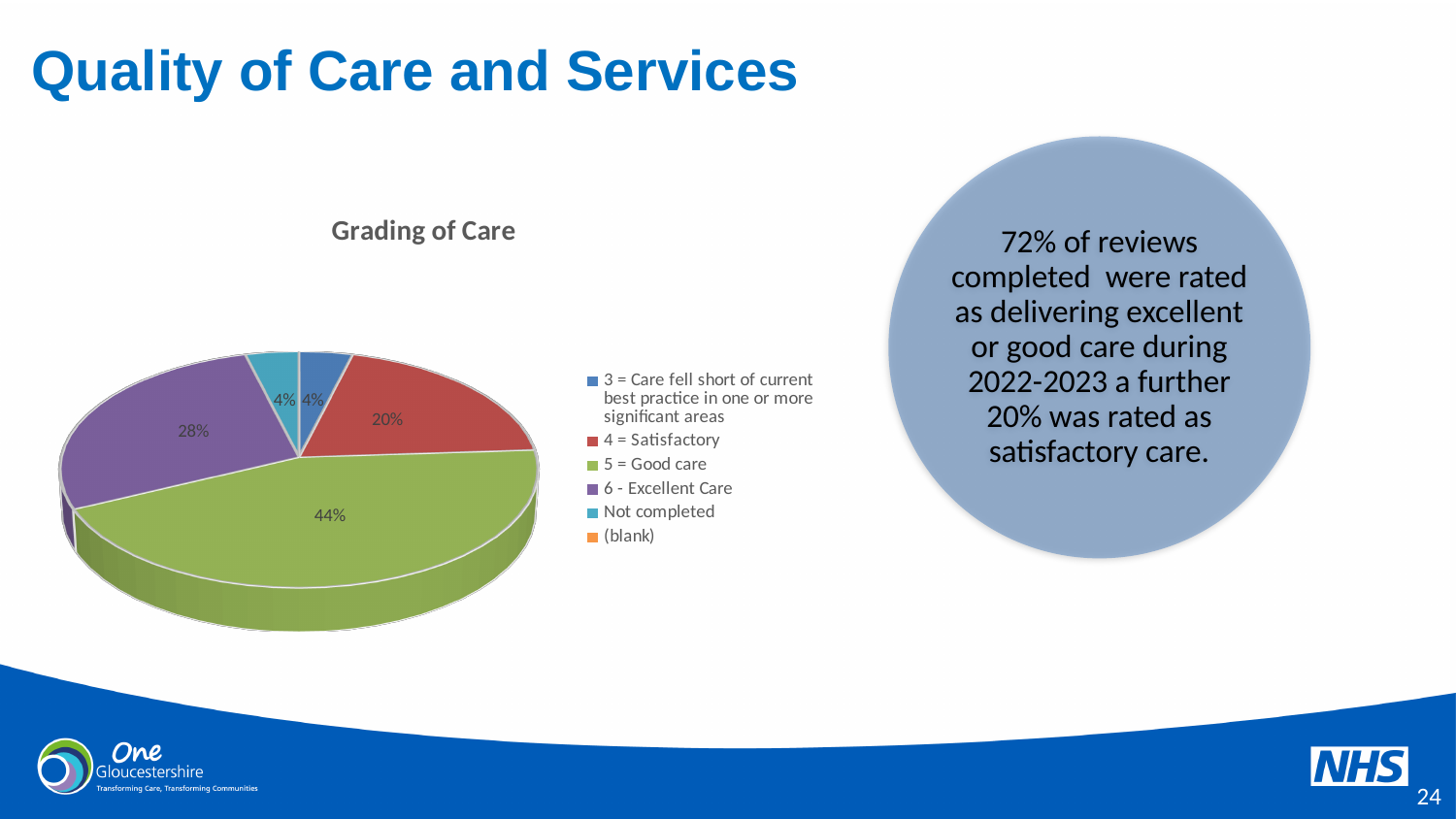
Which category has the largest share of the Grading of Care pie? 5 = Good care In the Grading of Care chart, what colour represents "5 = Good care"? Green What type of chart is shown under the title "Grading of Care"? Pie chart In the Grading of Care chart, what is the difference in percentage points between "5 = Good care" and "6 - Excellent Care"? 16% What percentage of the Grading of Care pie is "Not completed"? 4% What is the title of the pie chart on the slide? Grading of Care How many entries does the legend of the Grading of Care chart list? 6 In the Grading of Care chart, which is larger: the share for "6 - Excellent Care" or the share for "4 = Satisfactory"? 6 - Excellent Care What percentage of the Grading of Care pie is "4 = Satisfactory"? 20% In the Grading of Care chart, what is the combined share of "5 = Good care" and "6 - Excellent Care"? 72% What percentage of the Grading of Care pie is "5 = Good care"? 44% What percentage of the Grading of Care pie is "6 - Excellent Care"? 28%